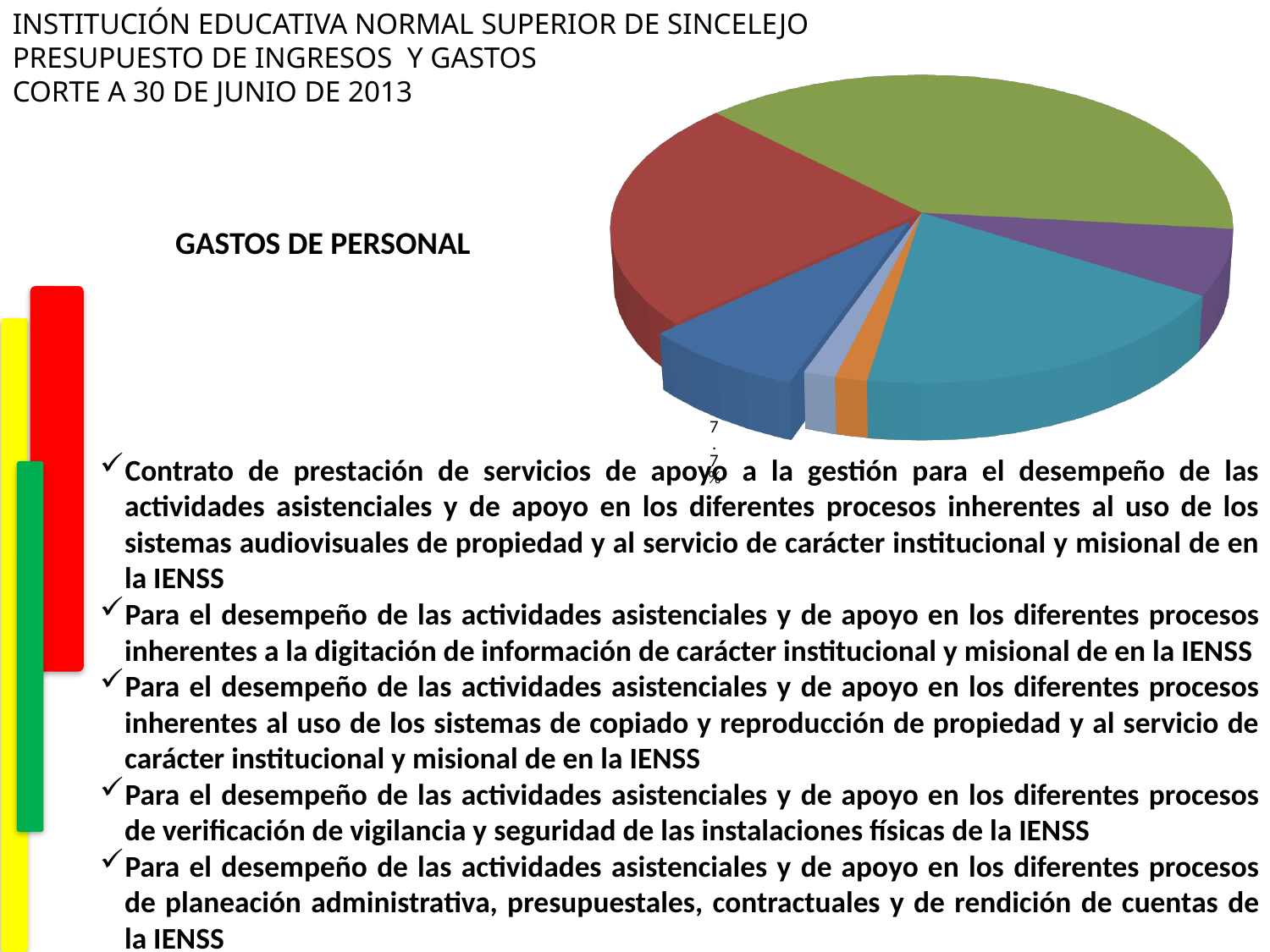
Does the pie chart include a legend? No How many slices does the pie chart have? 7 Is the green slice or the purple slice larger in the pie chart? green What kind of chart is shown on the slide? pie chart Which colour slice is the largest in the pie chart? green Is the red slice or the orange slice larger in the pie chart? red What percentage value is printed as a data label on the pie chart? 7.7% What is the title shown next to the pie chart? GASTOS DE PERSONAL